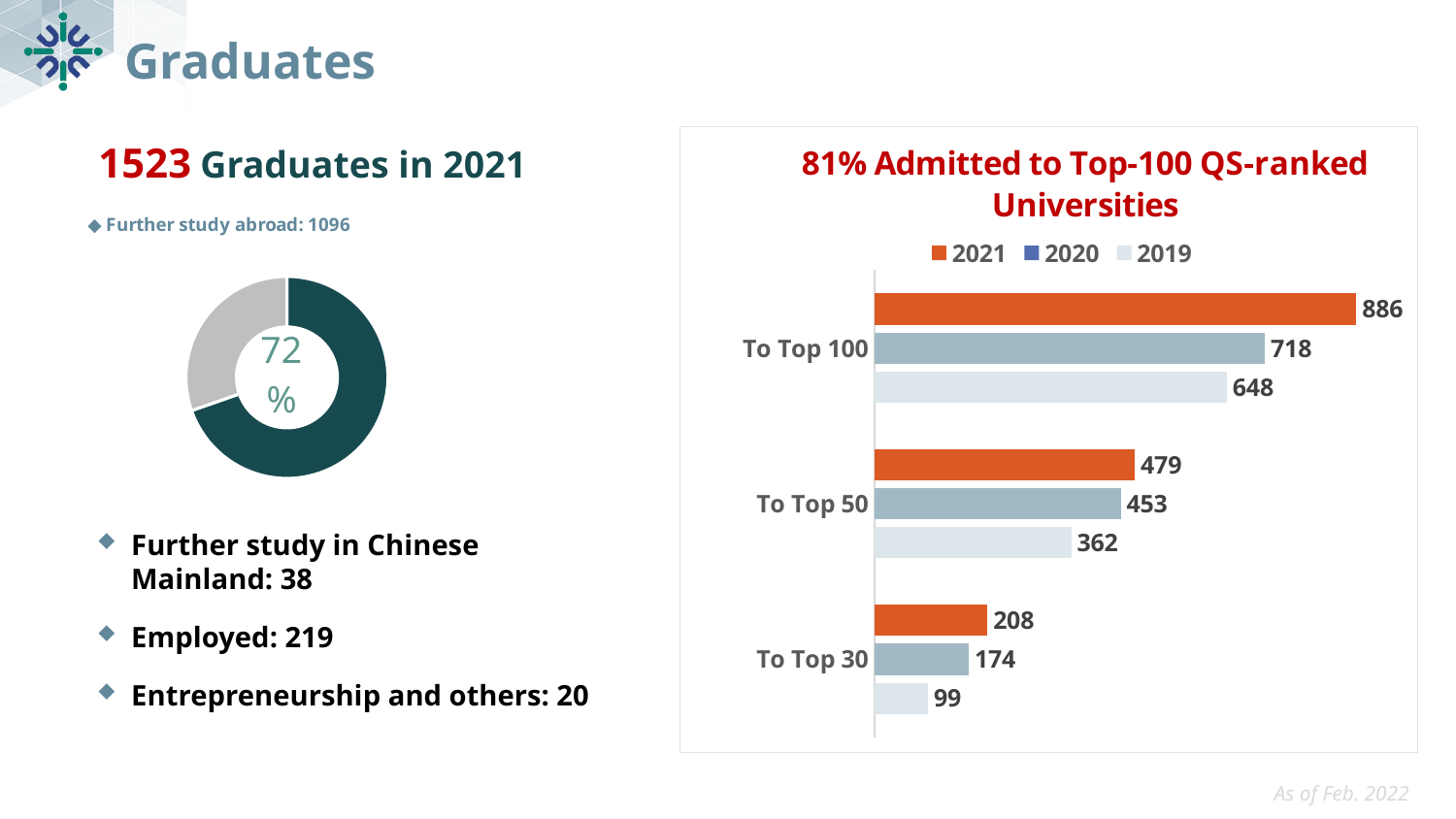
In the bar chart titled '81% Admitted to Top-100 QS-ranked Universities', what is the difference between the 2021 and 2020 values for 'To Top 100'? 168 What percentage is shown in the centre of the donut chart on the left side of the slide? 72% How many series does the legend list in the bar chart titled '81% Admitted to Top-100 QS-ranked Universities'? 3 What kind of chart is the chart on the right side of the slide? Bar chart In the bar chart titled '81% Admitted to Top-100 QS-ranked Universities', what is the 2019 value for 'To Top 30'? 99 How many categories are shown in the bar chart titled '81% Admitted to Top-100 QS-ranked Universities'? 3 In the bar chart titled '81% Admitted to Top-100 QS-ranked Universities', what is the 2021 value for 'To Top 100'? 886 In the bar chart titled '81% Admitted to Top-100 QS-ranked Universities', which category has the highest 2021 value? To Top 100 In the bar chart titled '81% Admitted to Top-100 QS-ranked Universities', which category has the lowest 2019 value? To Top 30 In the bar chart titled '81% Admitted to Top-100 QS-ranked Universities', which is larger: the 2021 value for 'To Top 30' or the 2019 value for 'To Top 50'? 2019 value for To Top 50 In the bar chart titled '81% Admitted to Top-100 QS-ranked Universities', what is the difference between the 2020 and 2019 values for 'To Top 50'? 91 In the bar chart titled '81% Admitted to Top-100 QS-ranked Universities', what is the 2020 value for 'To Top 50'? 453